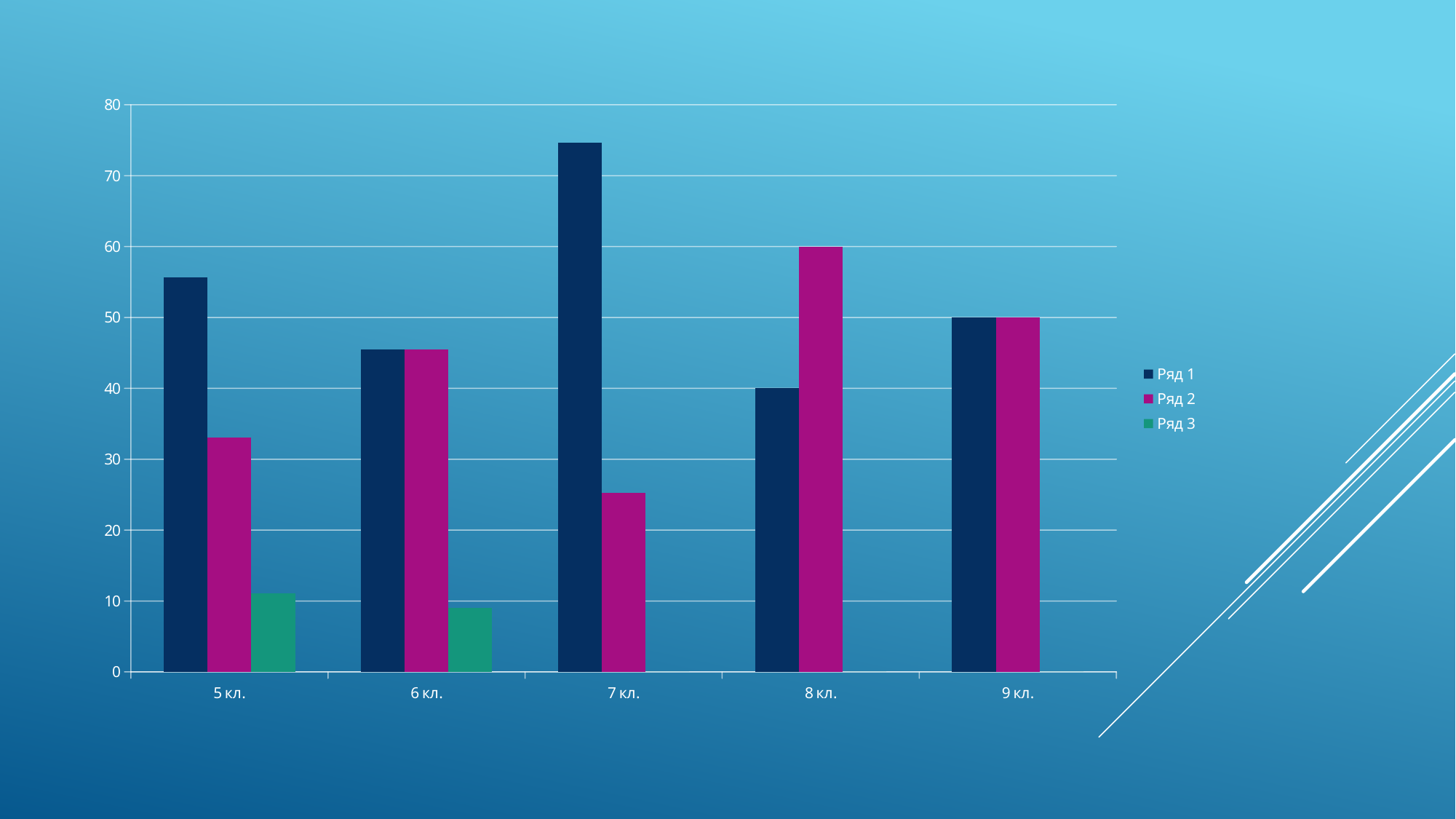
Which series has bars only for 5 кл. and 6 кл.? Ряд 3 How many categories are shown on the x axis? 5 How many series does the legend list? 3 For which category is the value of Ряд 1 the highest? 7 кл. For 5 кл., which series has the larger value, Ряд 1 or Ряд 2? Ряд 1 Is the value of Ряд 1 for 7 кл. greater or less than 70? greater For which category is the value of Ряд 2 the lowest? 7 кл. For which category is the value of Ряд 2 the highest? 8 кл. Is the value of Ряд 2 for 5 кл. greater or less than 30? greater What kind of chart is shown on the slide? bar chart For 8 кл., which series has the larger value, Ряд 1 or Ряд 2? Ряд 2 For which category is the value of Ряд 1 the lowest? 8 кл.